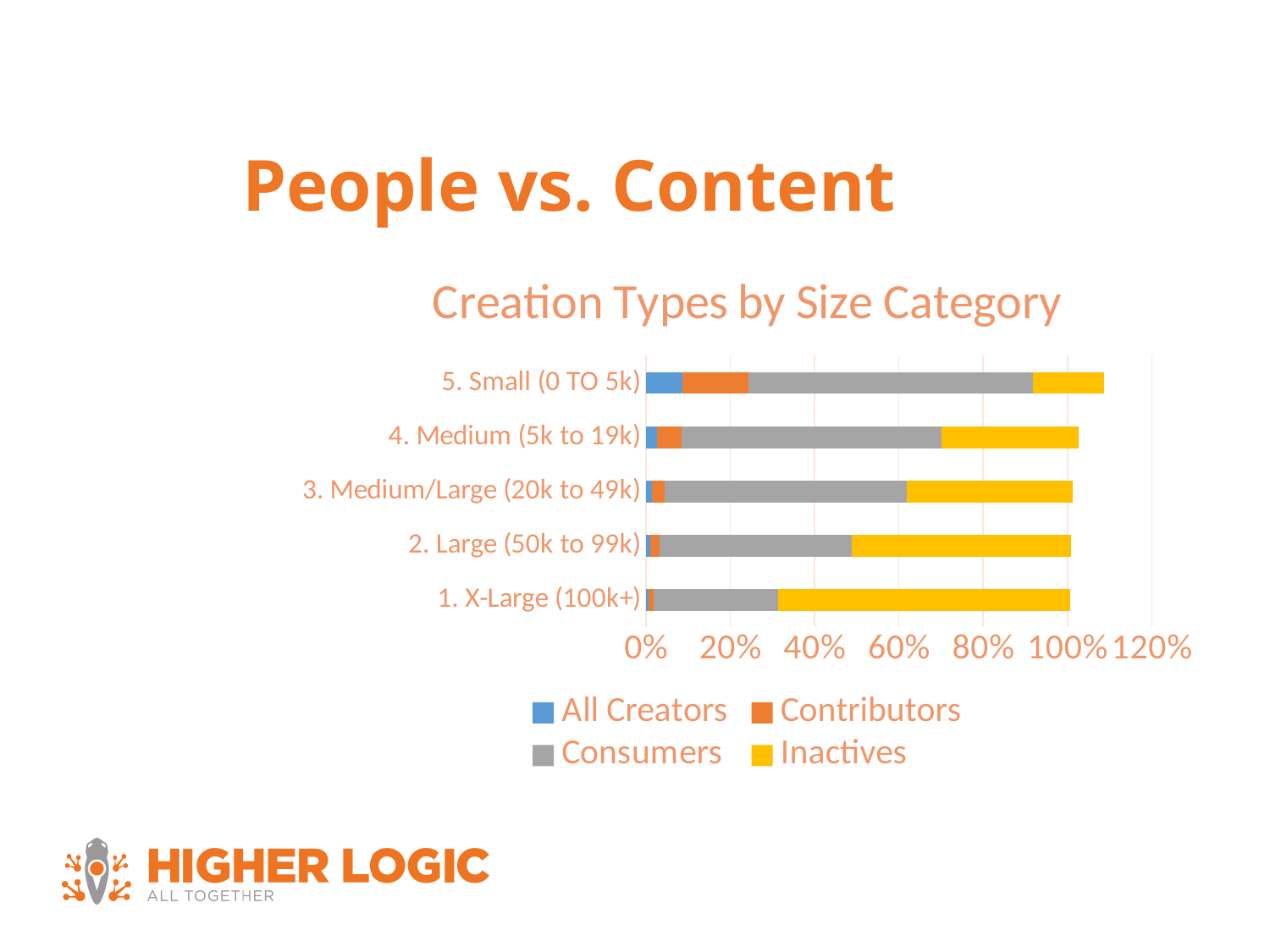
What is the title of the chart? Creation Types by Size Category Moving from the Small category down to the X-Large category, does the Inactives segment grow or shrink? Grow How many series does the legend list? 4 What kind of chart is shown on the slide? Stacked bar chart Is the Consumers segment larger for 5. Small (0 TO 5k) or for 1. X-Large (100k+)? 5. Small (0 TO 5k) Is the total bar length for 5. Small (0 TO 5k) greater or less than 100%? greater Which size category has the largest Inactives segment? 1. X-Large (100k+) How many size categories are plotted on the chart? 5 Which series is shown in yellow in the legend? Inactives Is the All Creators value for 5. Small (0 TO 5k) greater or less than 20%? less Which size category has the largest All Creators segment? 5. Small (0 TO 5k) Which size category has the smallest Inactives segment? 5. Small (0 TO 5k)